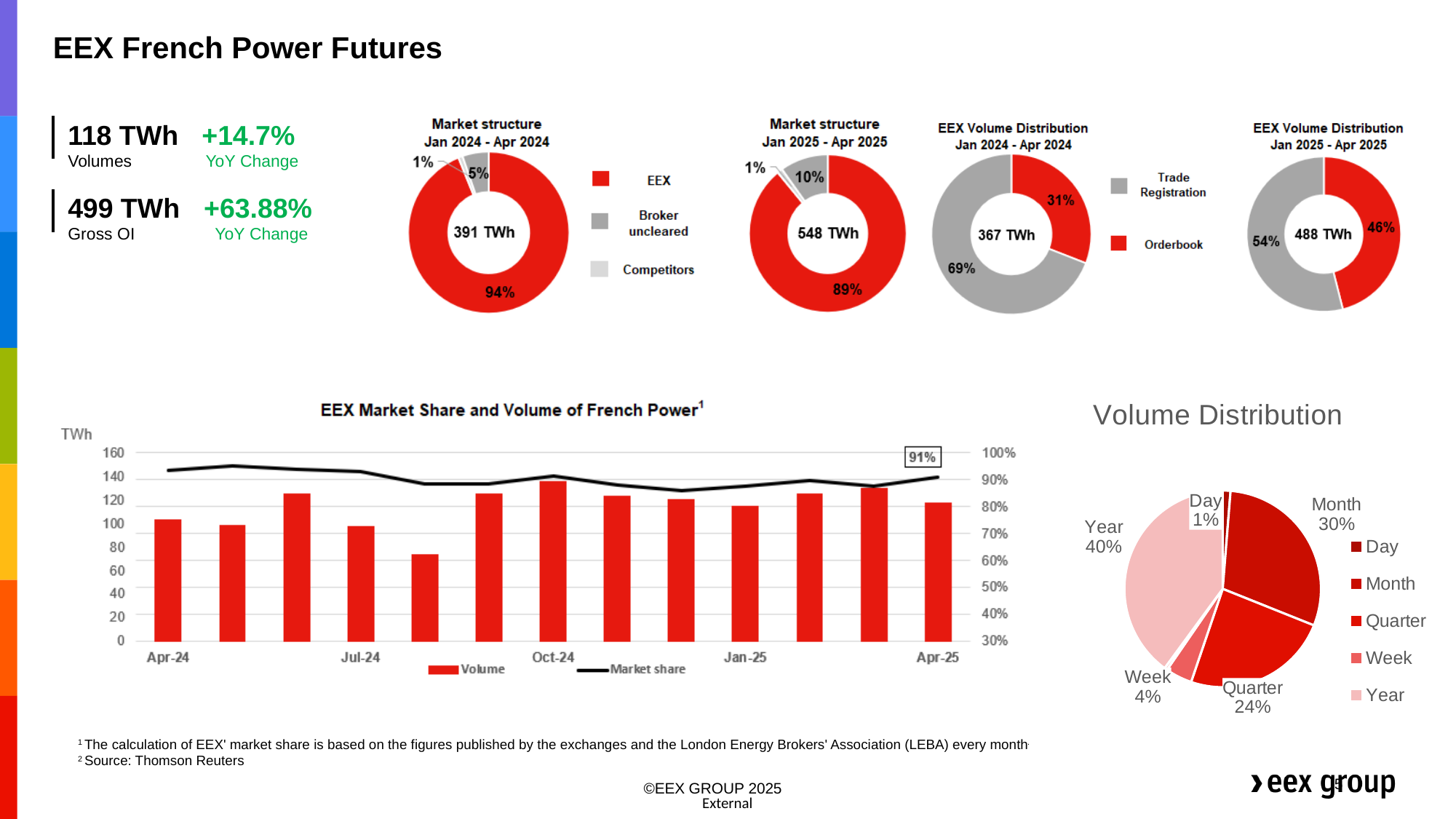
In the EEX Market Share and Volume of French Power chart, which month has the lowest volume bar? Aug-24 In the EEX Volume Distribution Jan 2024 - Apr 2024 donut chart, what share is Orderbook? 31% How many series does the legend of the Volume Distribution pie chart list? 5 In the EEX Market Share and Volume of French Power chart, what market share value is labelled for Apr-25? 91% In the Market structure Jan 2025 - Apr 2025 donut chart, what share does Broker uncleared hold? 10% In the Volume Distribution pie chart, what share does Year have? 40% In the EEX Volume Distribution Jan 2025 - Apr 2025 donut chart, which segment is larger, Trade Registration or Orderbook? Trade Registration In the EEX Volume Distribution Jan 2025 - Apr 2025 donut chart, what is the difference between the Trade Registration and Orderbook shares? 8% In the EEX Market Share and Volume of French Power chart, is the volume for Oct-24 greater or less than 120 TWh? greater What total volume is shown in the centre of the Market structure Jan 2025 - Apr 2025 donut chart? 548 TWh In the EEX Market Share and Volume of French Power chart, how many volume bars are plotted? 13 In the Market structure Jan 2024 - Apr 2024 donut chart, what share does EEX hold? 94%